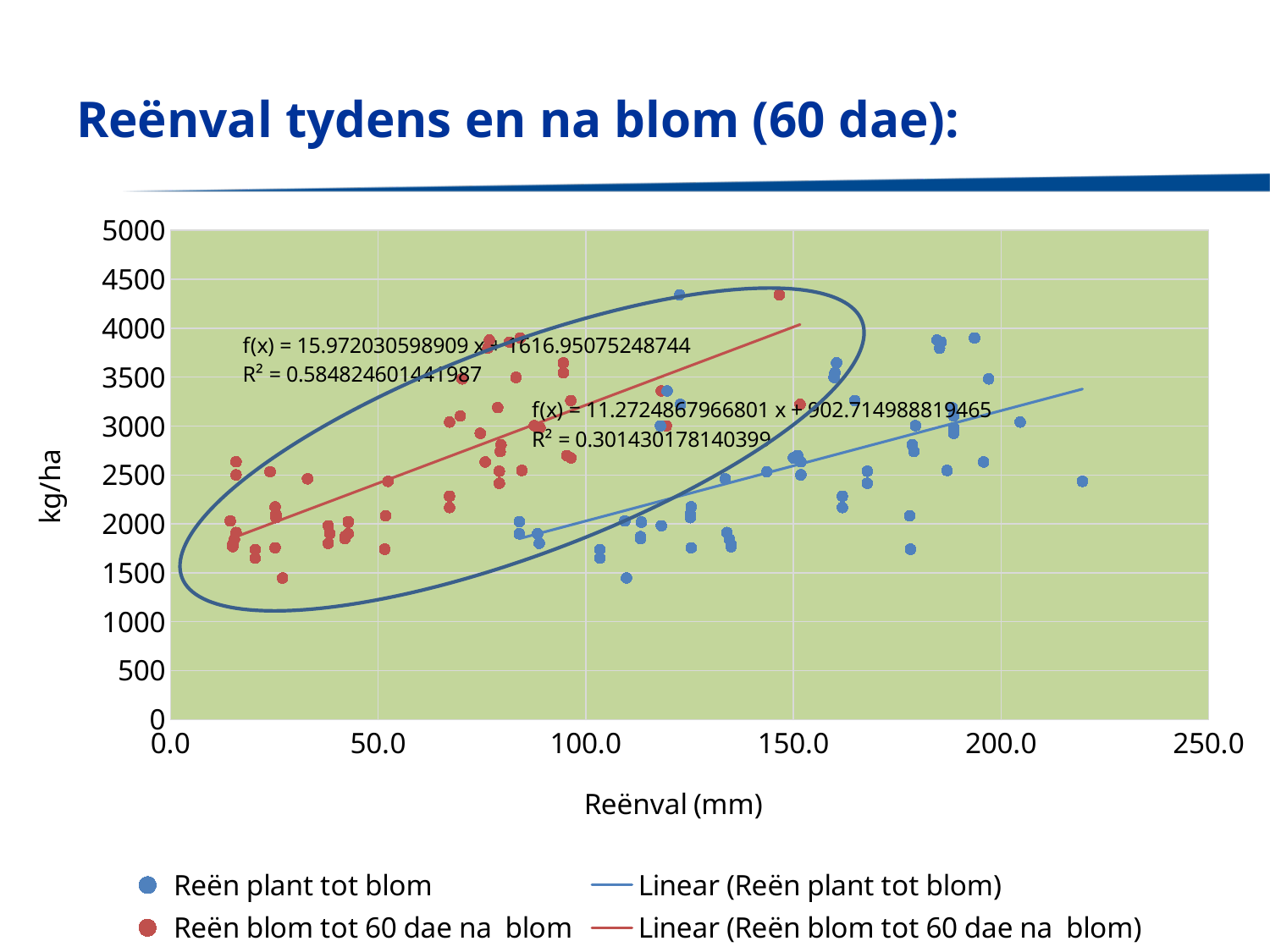
Is the 'Reën plant tot blom' point at about 220 mm rainfall greater or less than 2500 kg/ha? less What kind of chart is shown on the slide? Scatter chart Which printed R² value is larger: 0.584824601441987 or 0.301430178140399? 0.584824601441987 What is the maximum value shown on the x axis? 250.0 What is the R² value printed for the trendline with the equation f(x) = 15.972030598909 x + 1616.95075248744? 0.584824601441987 Is the highest 'Reën plant tot blom' point greater or less than 4000 kg/ha? greater Is the lowest 'Reën blom tot 60 dae na blom' point greater or less than 1500 kg/ha? less What is the title of the y axis of the chart? kg/ha What is the title of the x axis of the chart? Reënval (mm) How many entries does the chart legend list? 4 What is the R² value printed for the trendline with the equation f(x) = 11.2724867966801 x + 902.714988819465? 0.301430178140399 Do the two linear trendlines rise or fall as rainfall (Reënval) increases along the x axis? Rise